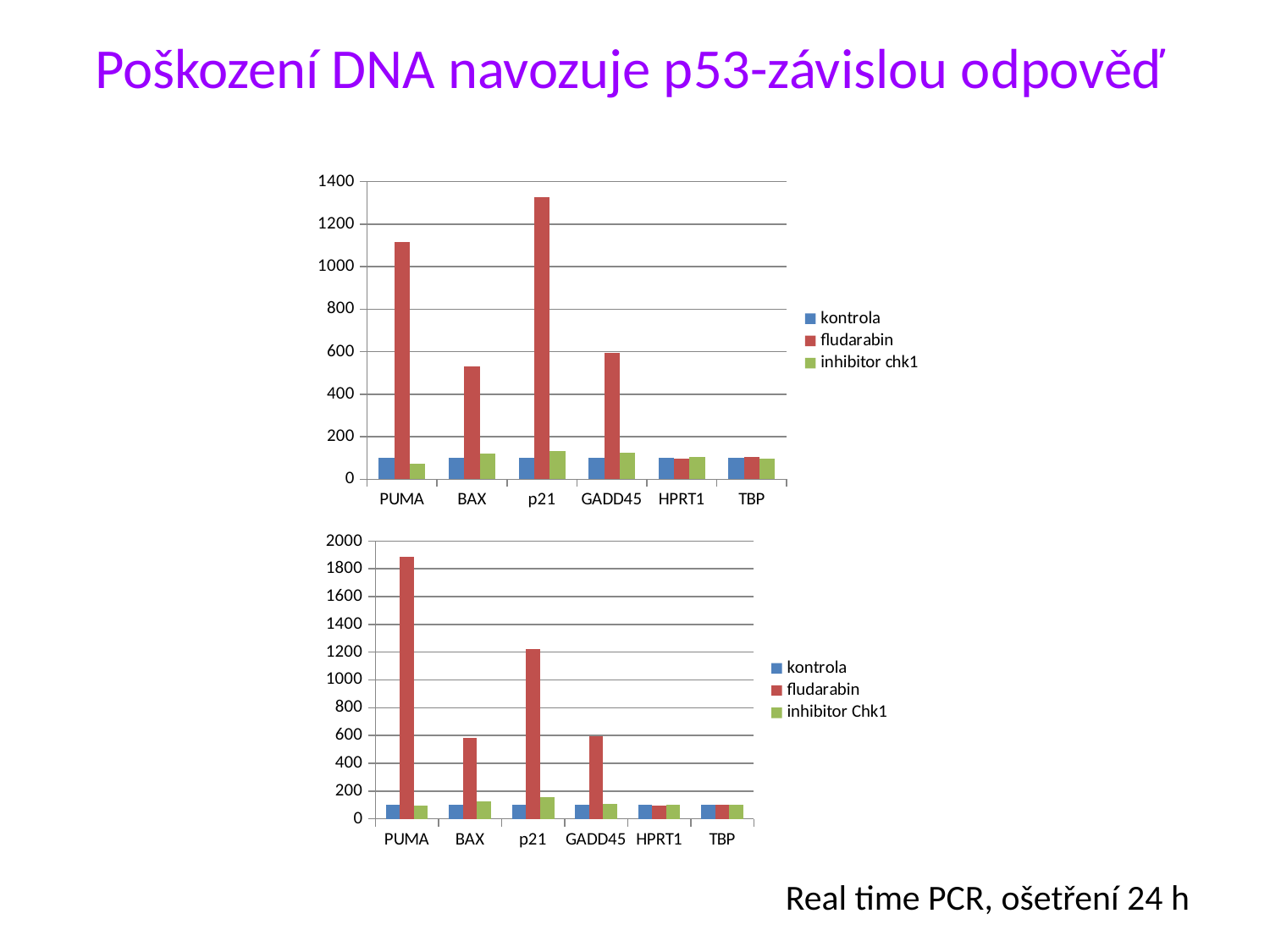
In the top chart, is the fludarabin value for PUMA greater or less than 1000? greater In the top chart, which is larger: the fludarabin value for PUMA or for p21? p21 In the bottom chart, which category has the highest fludarabin value? PUMA In the top chart, which category has the highest fludarabin value? p21 In the bottom chart, which is larger: the fludarabin value for PUMA or for p21? PUMA In the bottom chart, is the fludarabin value for PUMA greater or less than 1800? greater How many categories are shown on the x axis of the bottom chart? 6 In the bottom chart, is the fludarabin value for p21 greater or less than 1000? greater How many series does the legend of the top chart list? 3 What kind of chart is the top chart on the slide? bar chart